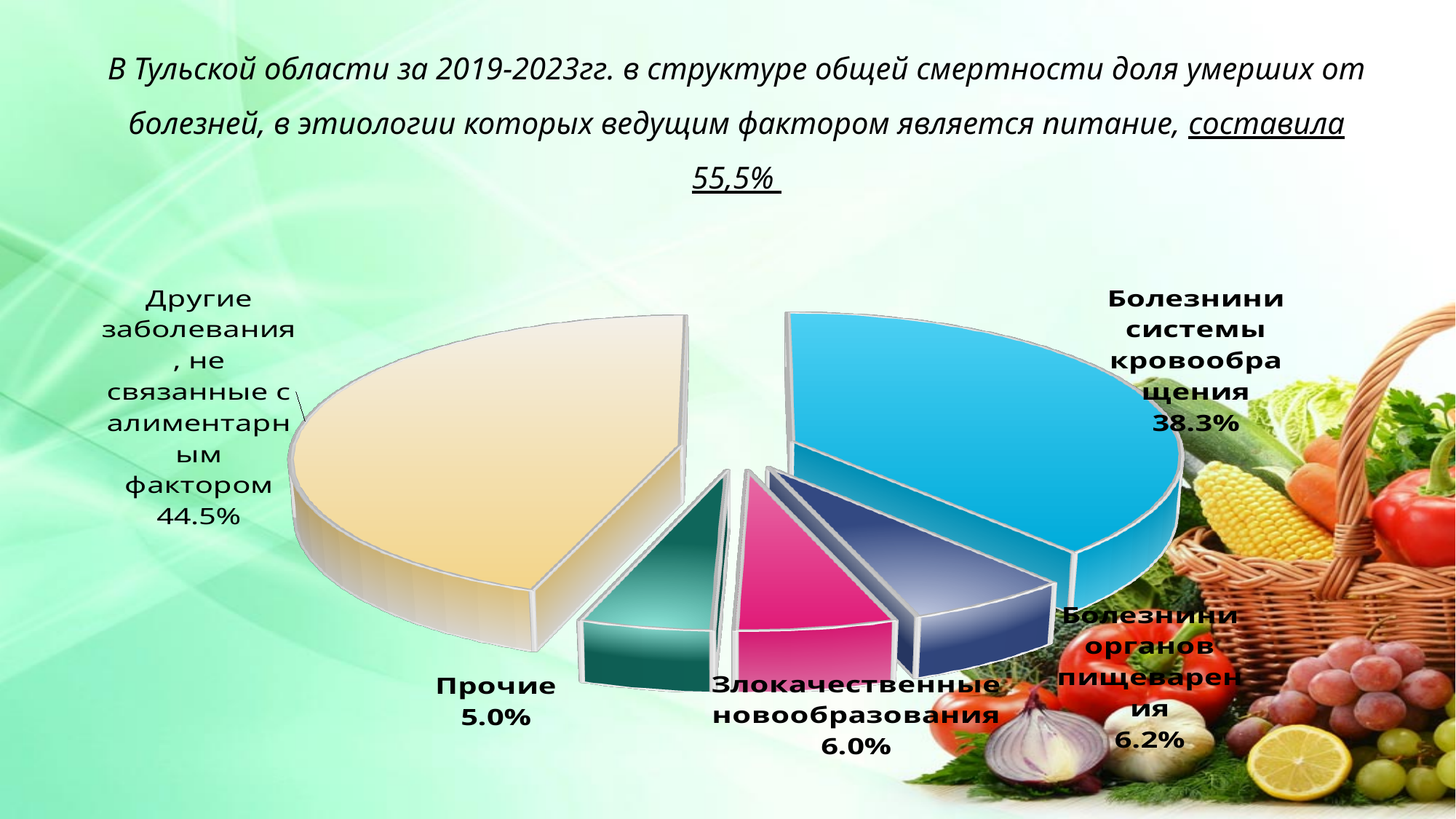
How many slices does the pie chart have? 5 What share of the pie does the Злокачественные новообразования slice represent? 6.0% What percentage is shown for Злокачественные новообразования? 6.0% Which slice of the pie chart is the smallest? Прочие What percentage is shown for Прочие? 5.0% What kind of chart is shown on the slide? pie chart What percentage is shown for Другие заболевания, не связанные с алиментарным фактором? 44.5% What is the difference in percentage points between Другие заболевания, не связанные с алиментарным фактором and Болезни системы кровообращения? 6.2 Which slice of the pie chart is the largest? Другие заболевания, не связанные с алиментарным фактором Which is larger: the share for Болезни органов пищеварения or the share for Прочие? Болезни органов пищеварения What percentage is shown for Болезни системы кровообращения? 38.3% What percentage is shown for Болезни органов пищеварения? 6.2%